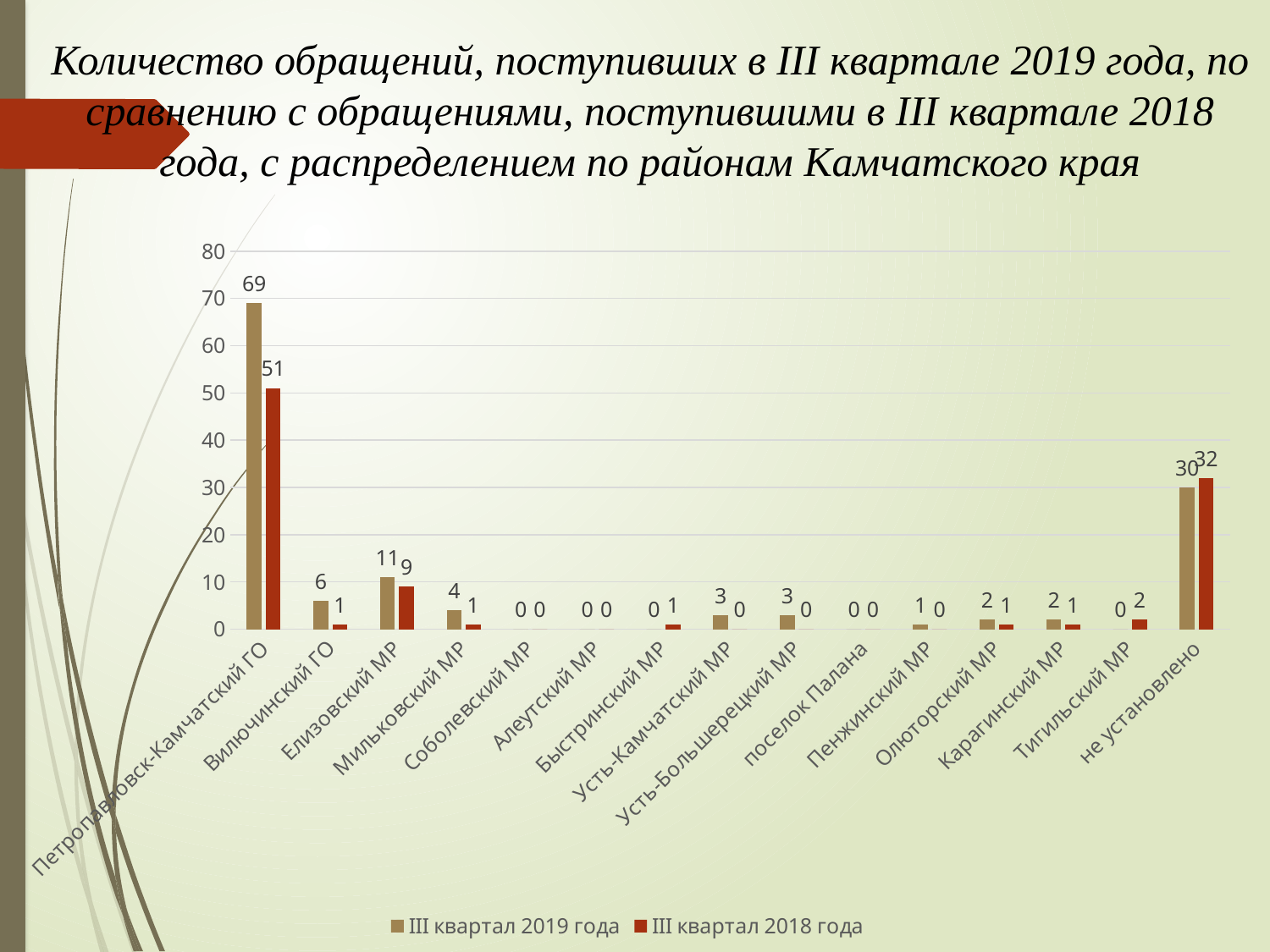
What is the difference between the III квартал 2019 года and III квартал 2018 года values for Петропавловск-Камчатский ГО? 18 How many categories are shown on the x axis? 15 What is the value for Тигильский МР in the III квартал 2018 года series? 2 What kind of chart is shown on the slide? Bar chart What is the value for Петропавловск-Камчатский ГО in the III квартал 2018 года series? 51 What is the value for Елизовский МР in the III квартал 2019 года series? 11 What is the value for Петропавловск-Камчатский ГО in the III квартал 2019 года series? 69 For не установлено, which series has the larger value: III квартал 2019 года or III квартал 2018 года? III квартал 2018 года What colour are the bars for the III квартал 2018 года series? Red What is the value for не установлено in the III квартал 2018 года series? 32 How many series does the legend list? 2 Which category has the highest value in the III квартал 2019 года series? Петропавловск-Камчатский ГО